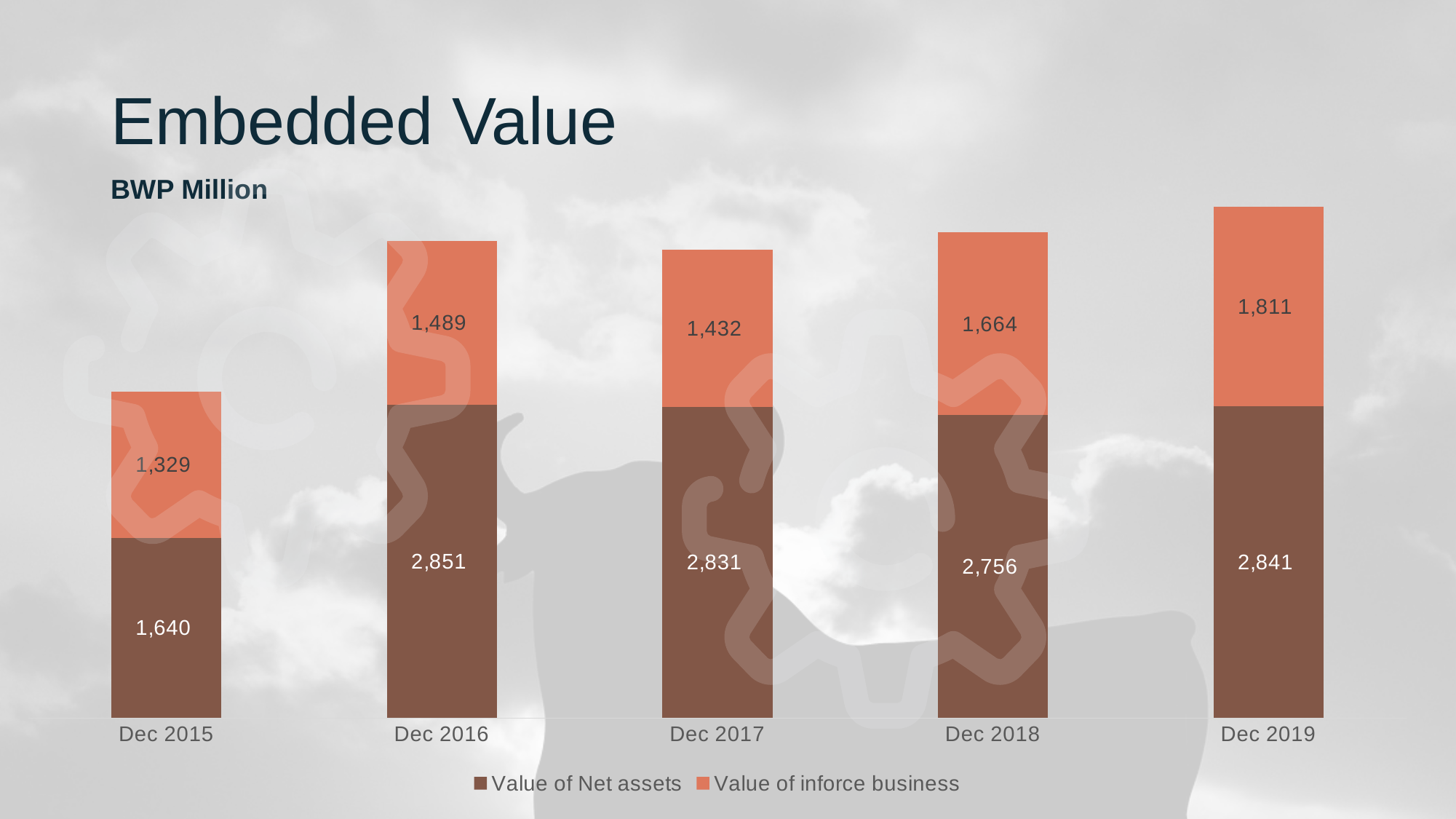
Which year has the highest Value of inforce business? Dec 2019 Which year has the lowest Value of Net assets? Dec 2015 What is the Value of Net assets for Dec 2016? 2,851 What type of chart is shown on the slide? Stacked bar chart What is the total embedded value (both segments) for Dec 2019? 4,652 Which is larger: the Value of inforce business in Dec 2018 or in Dec 2017? Dec 2018 What is the Value of inforce business for Dec 2015? 1,329 What is the difference between the Value of Net assets in Dec 2016 and Dec 2015? 1,211 What is the total of the stacked bar for Dec 2015? 2,969 How many years are shown on the x axis? 5 How many series does the legend list? 2 What is the Value of inforce business for Dec 2019? 1,811